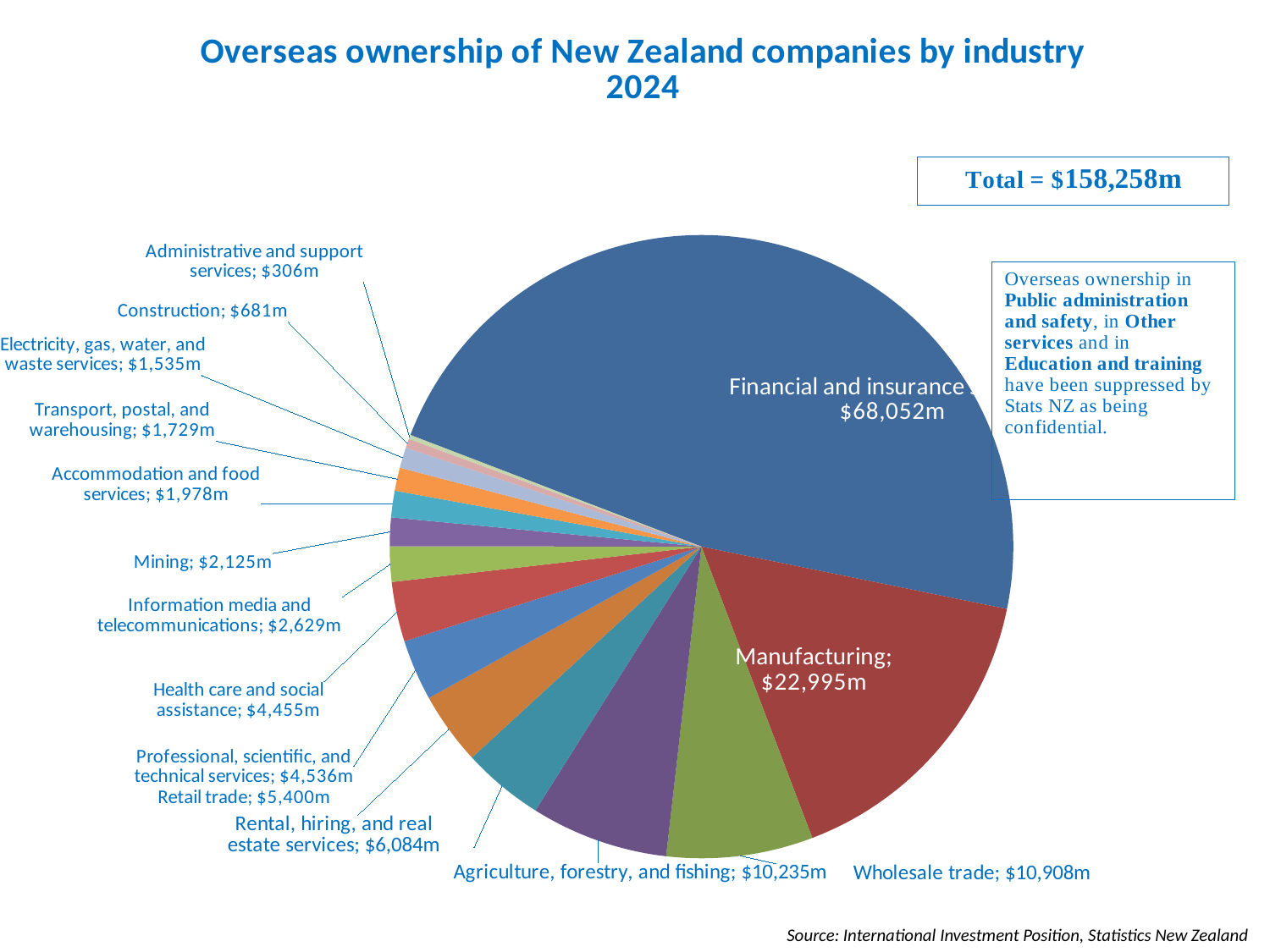
What is the value for Administrative and support services? $306m What is the value for Agriculture, forestry, and fishing? $10,235m What is the value for Financial and insurance? $68,052m What is the difference between Financial and insurance and Manufacturing? $45,057m Which is larger, Health care and social assistance or Professional, scientific, and technical services? Professional, scientific, and technical services What is the value for Manufacturing? $22,995m What is the difference between Wholesale trade and Agriculture, forestry, and fishing? $673m Which labelled industry has the smallest value? Administrative and support services Which industry has the largest slice of the pie? Financial and insurance What total value is shown in the box on the slide? $158,258m What is the value for Retail trade? $5,400m What kind of chart is shown on the slide? Pie chart